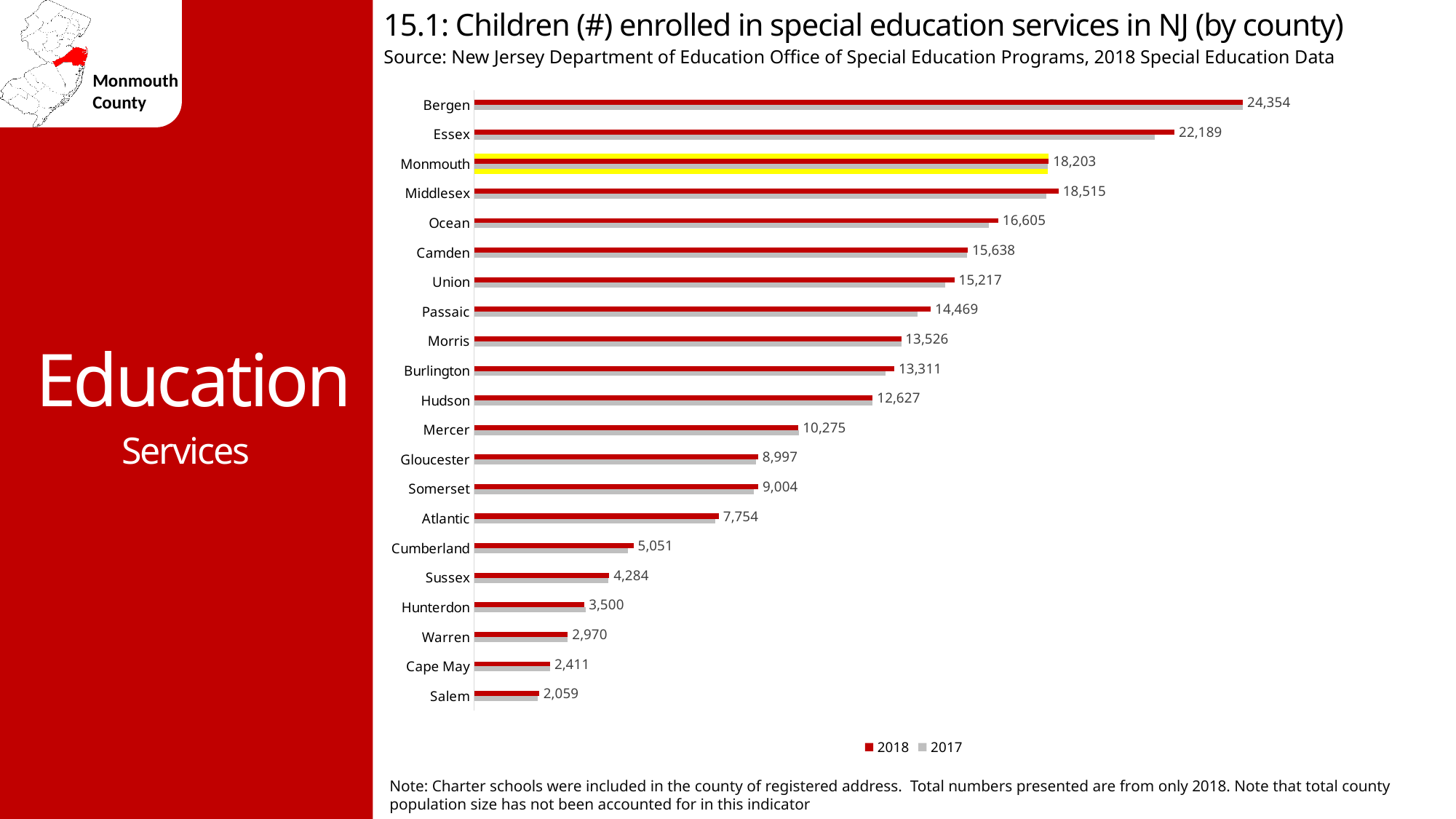
What is the 2018 value for Ocean? 16,605 Which has the larger 2018 value, Mercer or Hudson? Hudson What kind of chart is shown? Bar chart Which county has the lowest 2018 value? Salem What is the difference between the 2018 values for Bergen and Essex? 2,165 What is the 2018 value for Salem? 2,059 Which county has the highest 2018 value? Bergen What is the difference between the 2018 values for Middlesex and Monmouth? 312 What is the 2018 value for Bergen? 24,354 What is the 2018 value for Monmouth? 18,203 How many series does the legend list? 2 How many counties are shown on the chart? 21